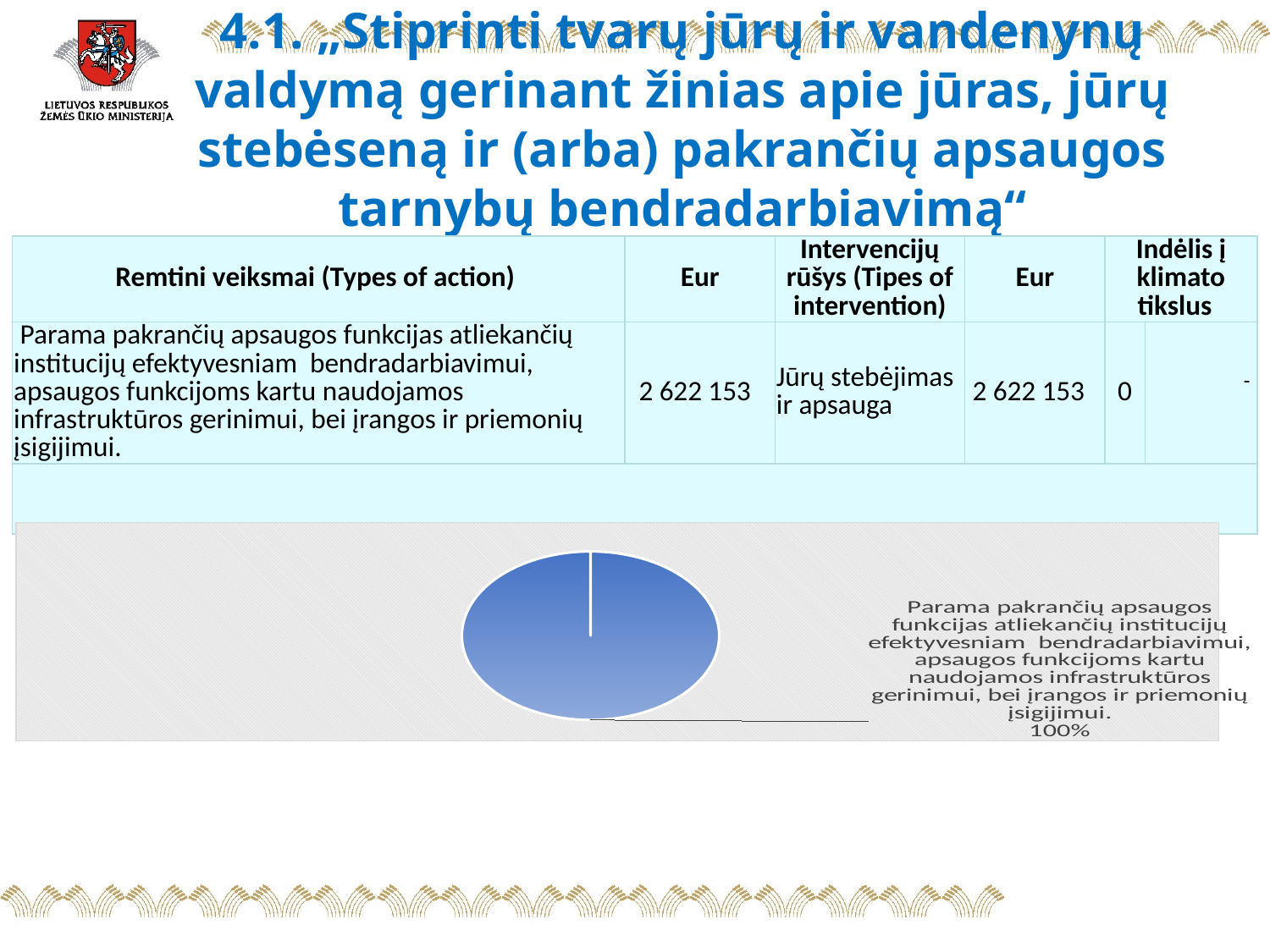
What share of the pie does the slice for "Parama pakrančių apsaugos funkcijas atliekančių institucijų efektyvesniam bendradarbiavimui..." represent? 100% What colour is the single slice of the pie chart? blue Which category makes up the entire pie chart? Parama pakrančių apsaugos funkcijas atliekančių institucijų efektyvesniam bendradarbiavimui, apsaugos funkcijoms kartu naudojamos infrastruktūros gerinimui, bei įrangos ir priemonių įsigijimui. What kind of chart is shown on the slide? pie chart How many slices does the pie chart have? 1 What percentage is printed as the data label on the pie chart? 100%